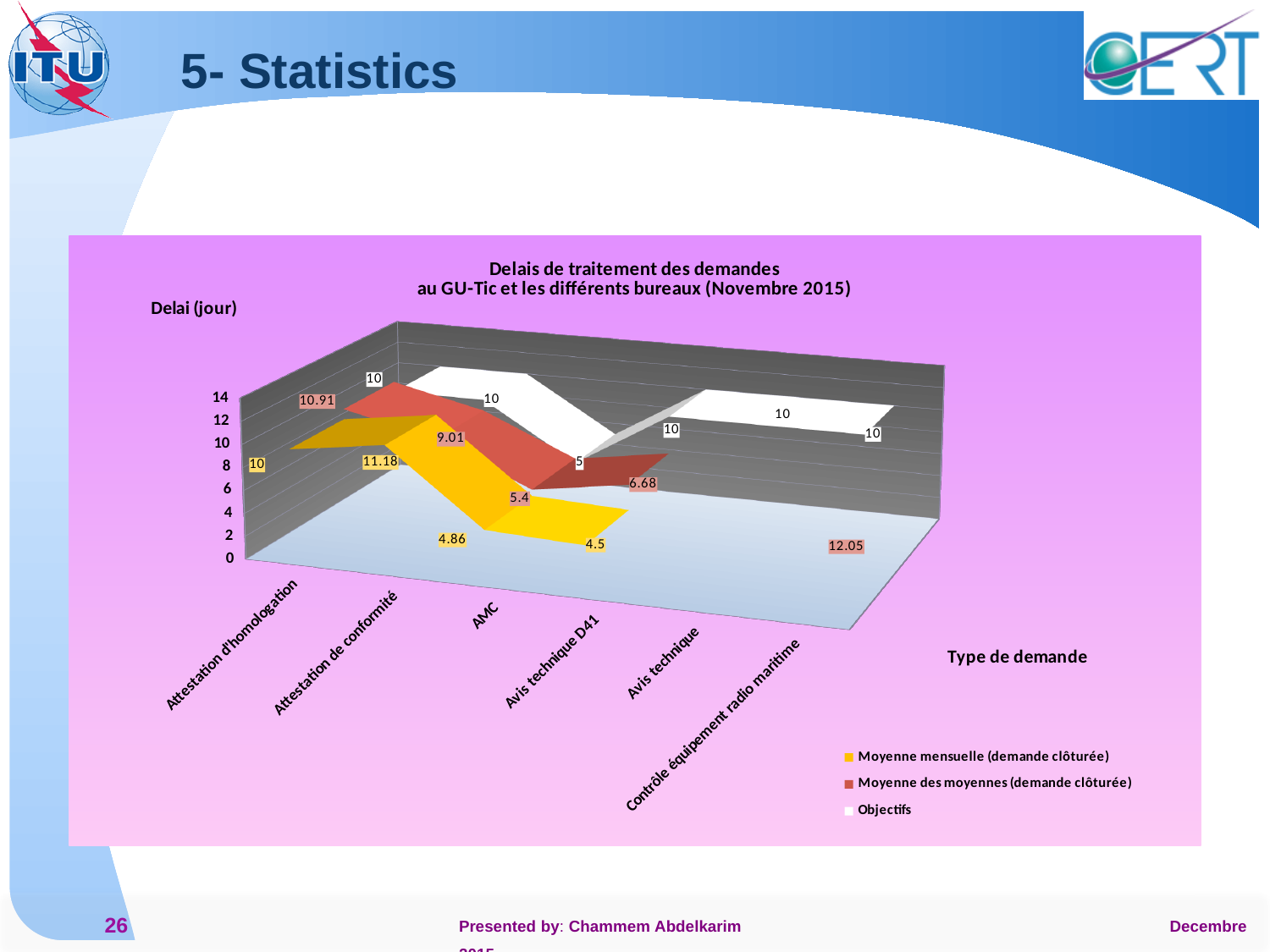
How many series does the chart legend list? 3 What kind of chart is shown on the slide? 3D line chart How many types of demande (categories) are shown on the x axis of the chart? 6 Which series is drawn in white in the chart? Objectifs What is the lowest data label value shown on the chart? 4.5 What is the highest data label value shown on the chart? 12.05 What is the difference between the data labels 10.91 and 4.86? 6.05 Which is larger, the data label 11.18 or the data label 9.01? 11.18 What is the title of the chart? Delais de traitement des demandes au GU-Tic et les différents bureaux (Novembre 2015) What is the difference between the data labels 12.05 and 6.68? 5.37